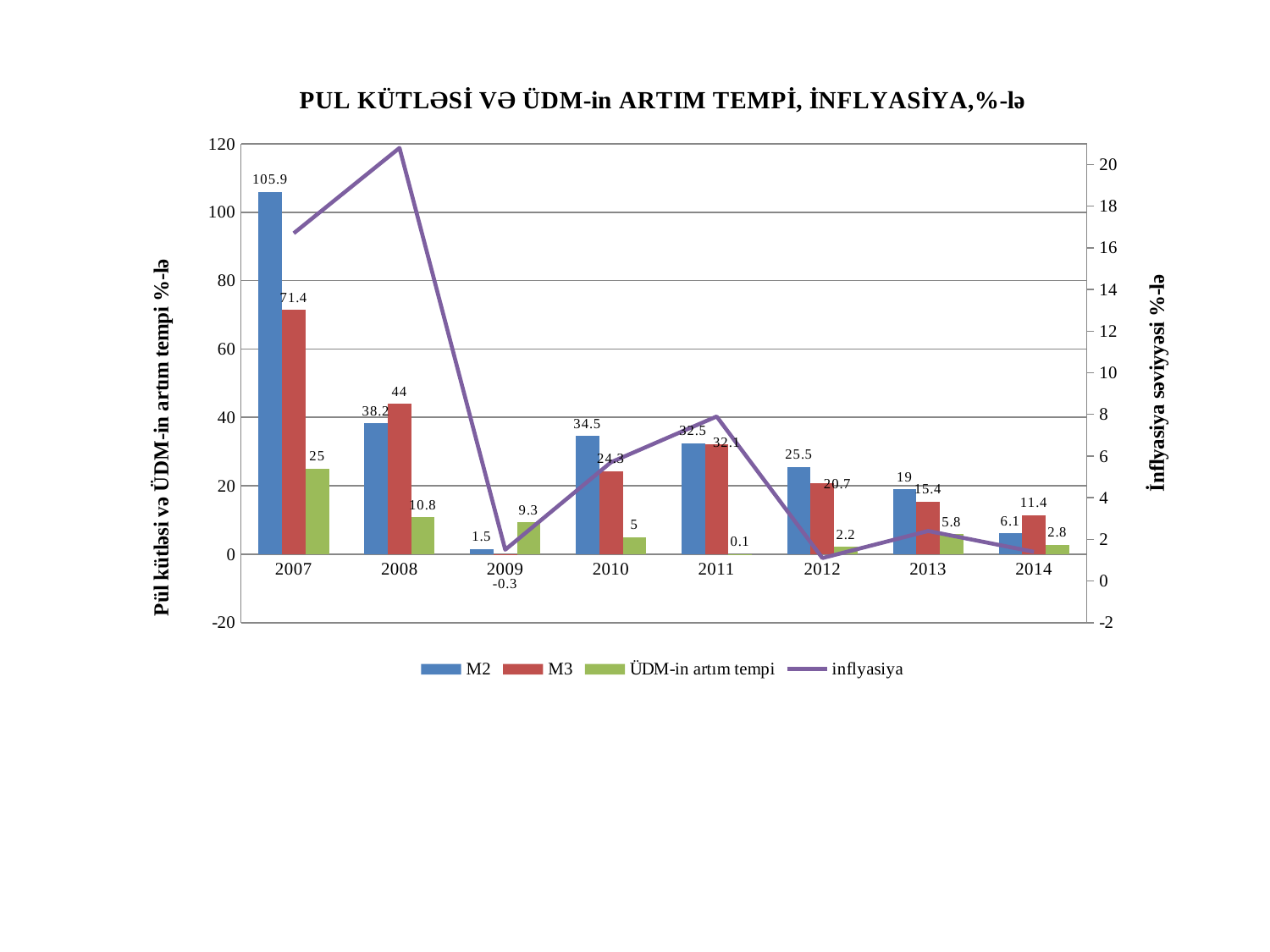
How many years are shown on the x axis? 8 What is the difference between the M2 and M3 values in 2007? 34.5 What is the M2 value for 2007? 105.9 How many series does the legend list? 4 Is the inflyasiya value for 2008 greater or less than 18? greater Is the inflyasiya value for 2009 greater or less than 4? less What is the M3 value for 2014? 11.4 In which year is the M3 value lowest? 2009 Which series is drawn as a line rather than bars? inflyasiya In which year is the M2 value highest? 2007 Which is larger in 2008, M2 or M3? M3 What is the ÜDM-in artım tempi value for 2009? 9.3